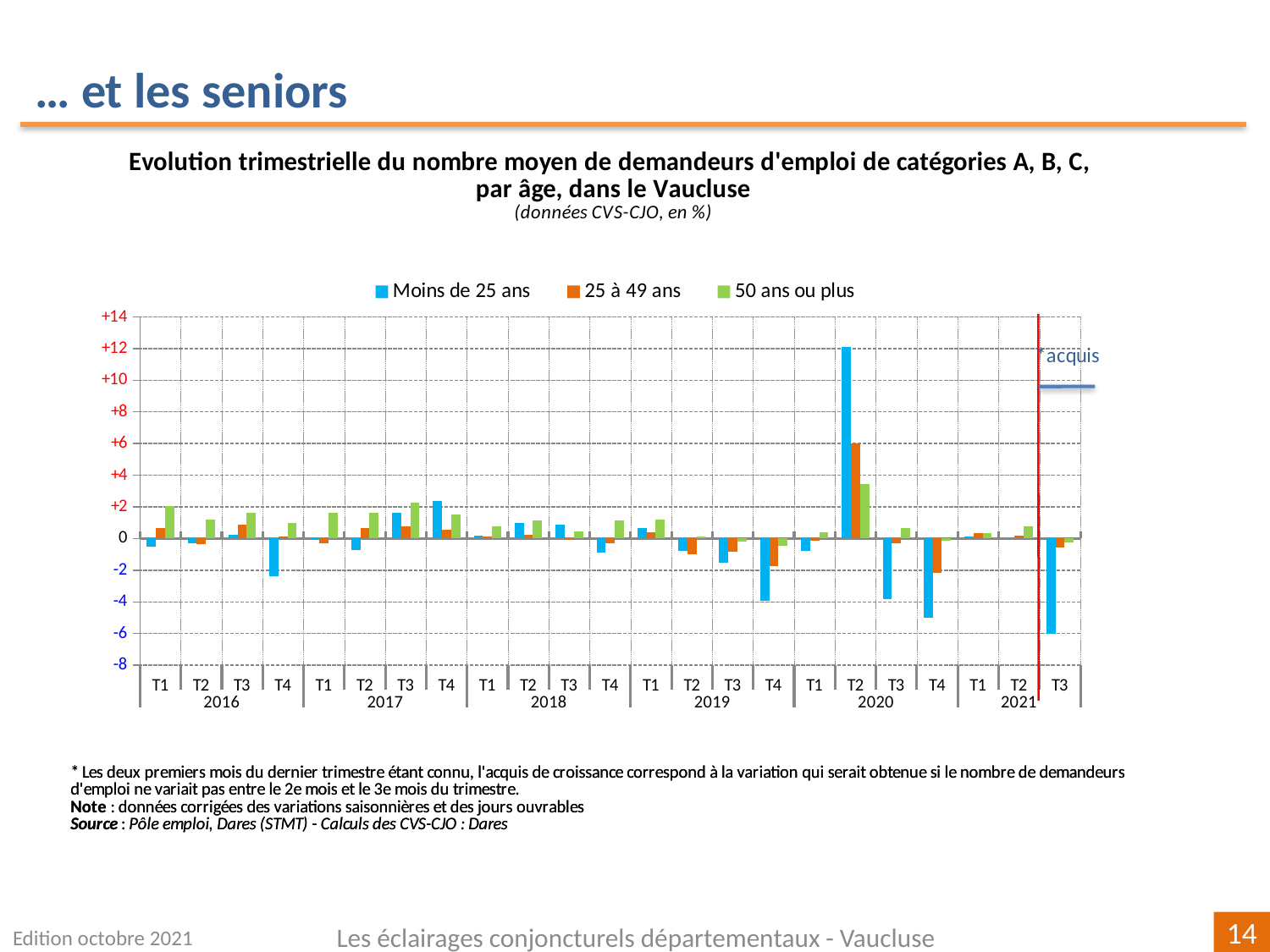
In T4 2019, which series has the lower value: 'Moins de 25 ans' or '50 ans ou plus'? Moins de 25 ans Is the value for 'Moins de 25 ans' in T3 2021 greater or less than -4? less What kind of chart is shown on the slide? bar chart How many series does the legend list? 3 Is the value for '25 à 49 ans' in T2 2020 greater or less than +4? greater In which quarter does the 'Moins de 25 ans' series reach its lowest value? T3 2021 In which quarter does the 'Moins de 25 ans' series reach its highest value? T2 2020 Is the value for 'Moins de 25 ans' in T4 2020 greater or less than -4? less How many quarters are plotted along the x axis? 23 Which colour represents the '50 ans ou plus' series in the legend? green In T2 2020, which series has the larger value: 'Moins de 25 ans' or '25 à 49 ans'? Moins de 25 ans